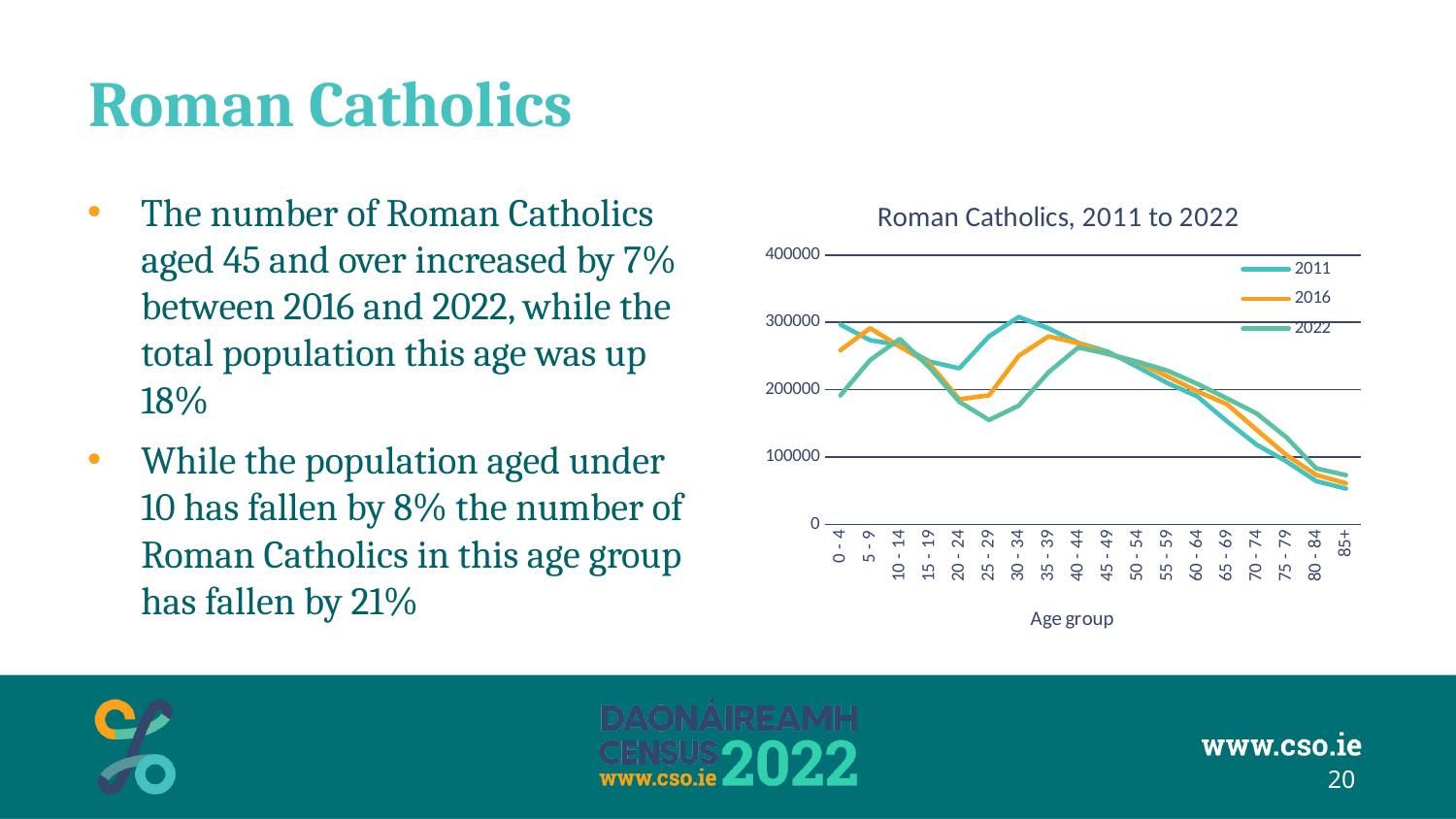
For the 0 - 4 age group, which series has the larger value, 2011 or 2022? 2011 How many age groups are shown on the x axis of the chart? 18 Is the 2011 value for the 85+ age group greater or less than 100000? less Do the values for the 2016 series rise or fall from the 45 - 49 age group to the 85+ age group? Fall How many series does the chart's legend list? 3 Which age group has the lowest value for the 2011 series? 85+ What is the label of the x axis of the chart? Age group Is the 2022 value for the 25 - 29 age group greater or less than 200000? less Is the 2011 value for the 0 - 4 age group greater or less than 200000? greater What is the title of the chart? Roman Catholics, 2011 to 2022 What type of chart is shown on the slide? Line chart